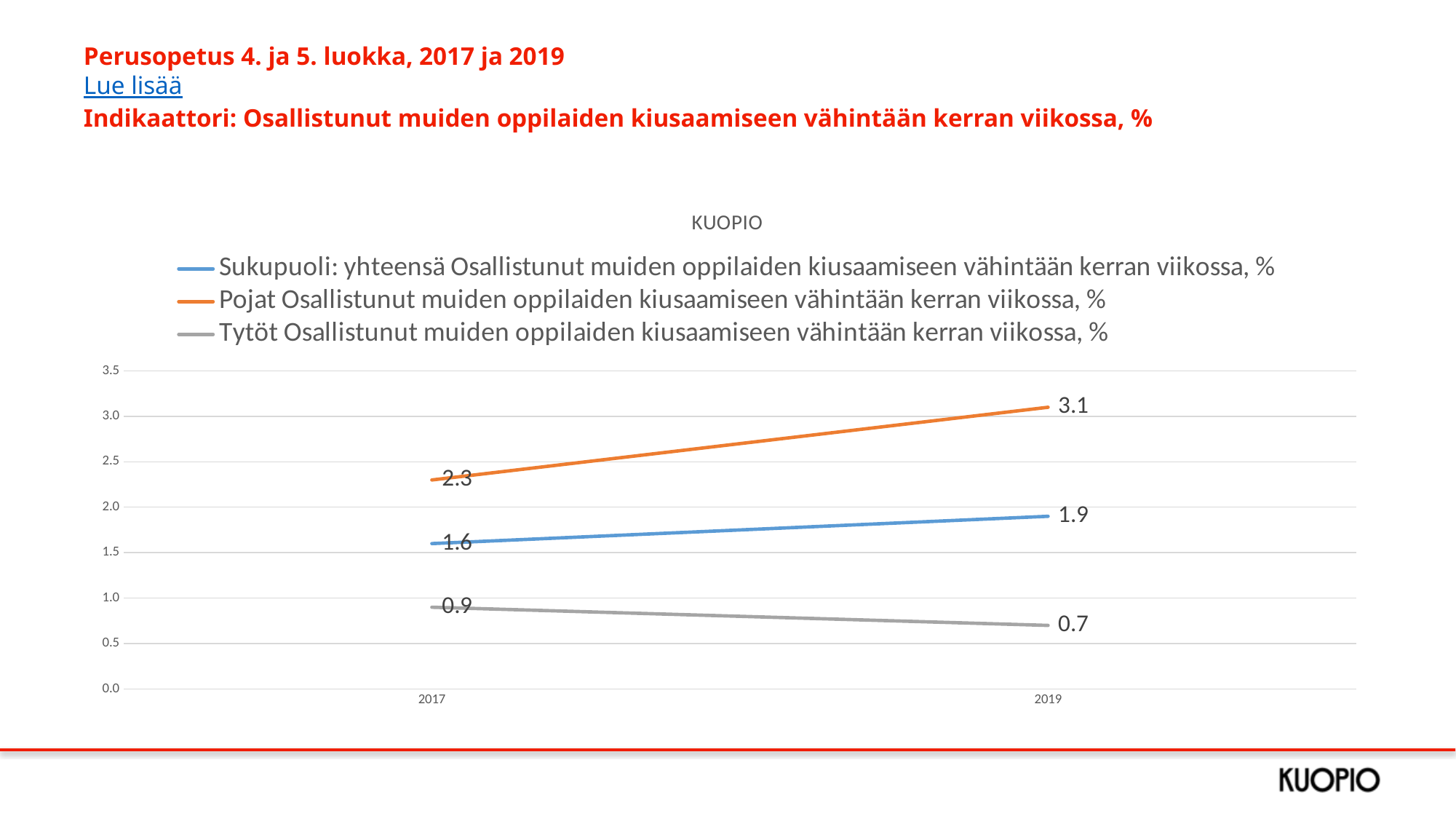
What is the value for Pojat (boys) in 2017? 2.3 What is the difference between the Pojat and Tytöt values in 2019? 2.4 Which series has the highest value in 2019? Pojat Which series has the lowest value in 2017? Tytöt Is the Tytöt (girls) value in 2019 larger or smaller than the Tytöt value in 2017? smaller By how much did the Pojat (boys) value change from 2017 to 2019? 0.8 What is the value for Tytöt (girls) in 2017? 0.9 Does the Tytöt (girls) line rise or fall from 2017 to 2019? fall How many series does the legend list? 3 What kind of chart is shown on the slide? line chart What is the value for Pojat (boys) in 2019? 3.1 What is the value for Sukupuoli: yhteensä (total) in 2019? 1.9